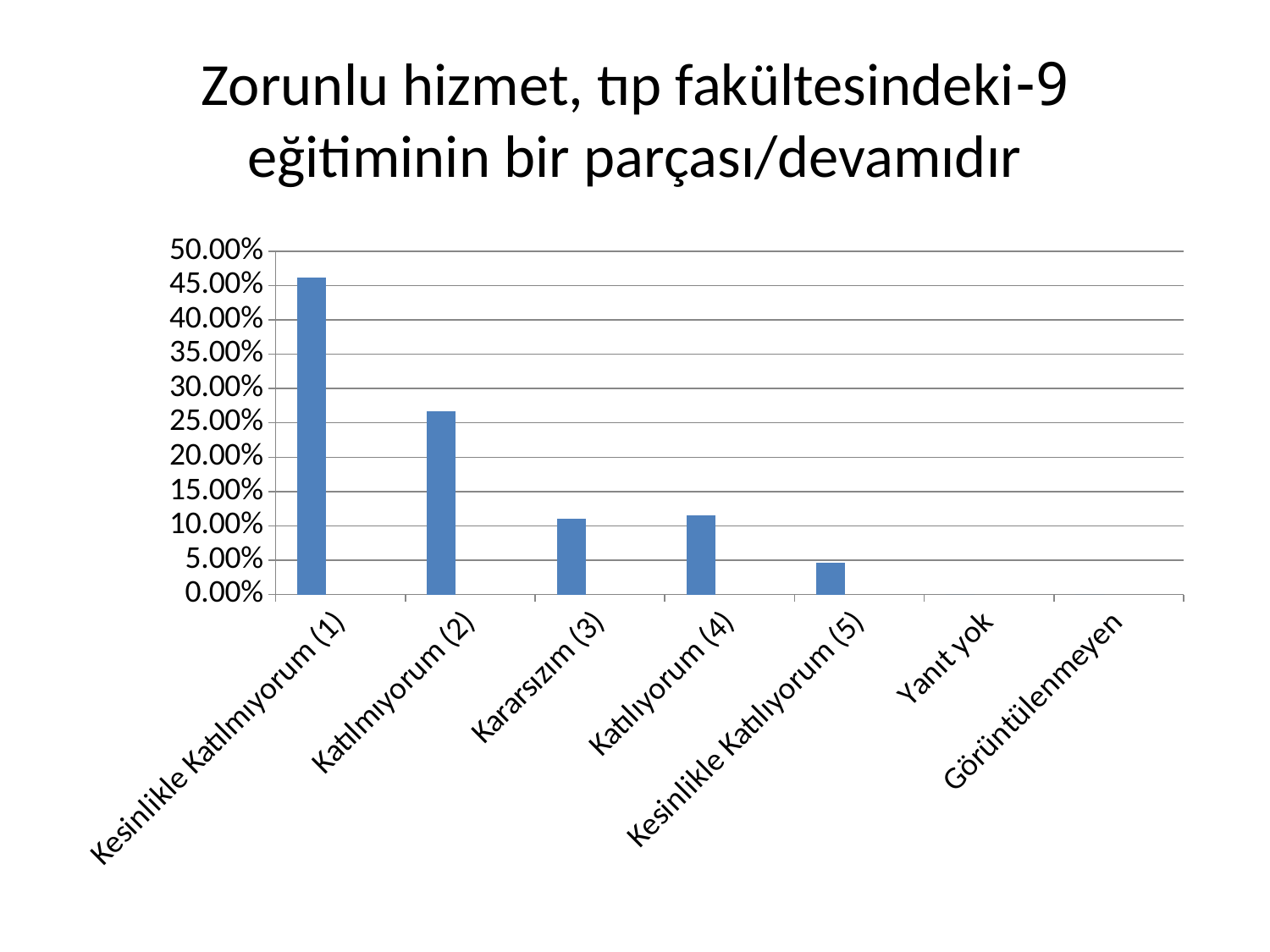
How many categories are shown on the x axis of the chart? 7 Is the value for Katılıyorum (4) greater or less than 15.00%? less Which is larger, the value for Kesinlikle Katılmıyorum (1) or the value for Katılmıyorum (2)? Kesinlikle Katılmıyorum (1) Is the value for Kesinlikle Katılıyorum (5) greater or less than 10.00%? less What is the maximum value shown on the y axis of the chart? 50.00% Is the value for Katılmıyorum (2) greater or less than 20.00%? greater What kind of chart is shown on the slide? bar chart Which is larger, the value for Katılmıyorum (2) or the value for Kesinlikle Katılıyorum (5)? Katılmıyorum (2) Which category has the highest value in the chart? Kesinlikle Katılmıyorum (1)